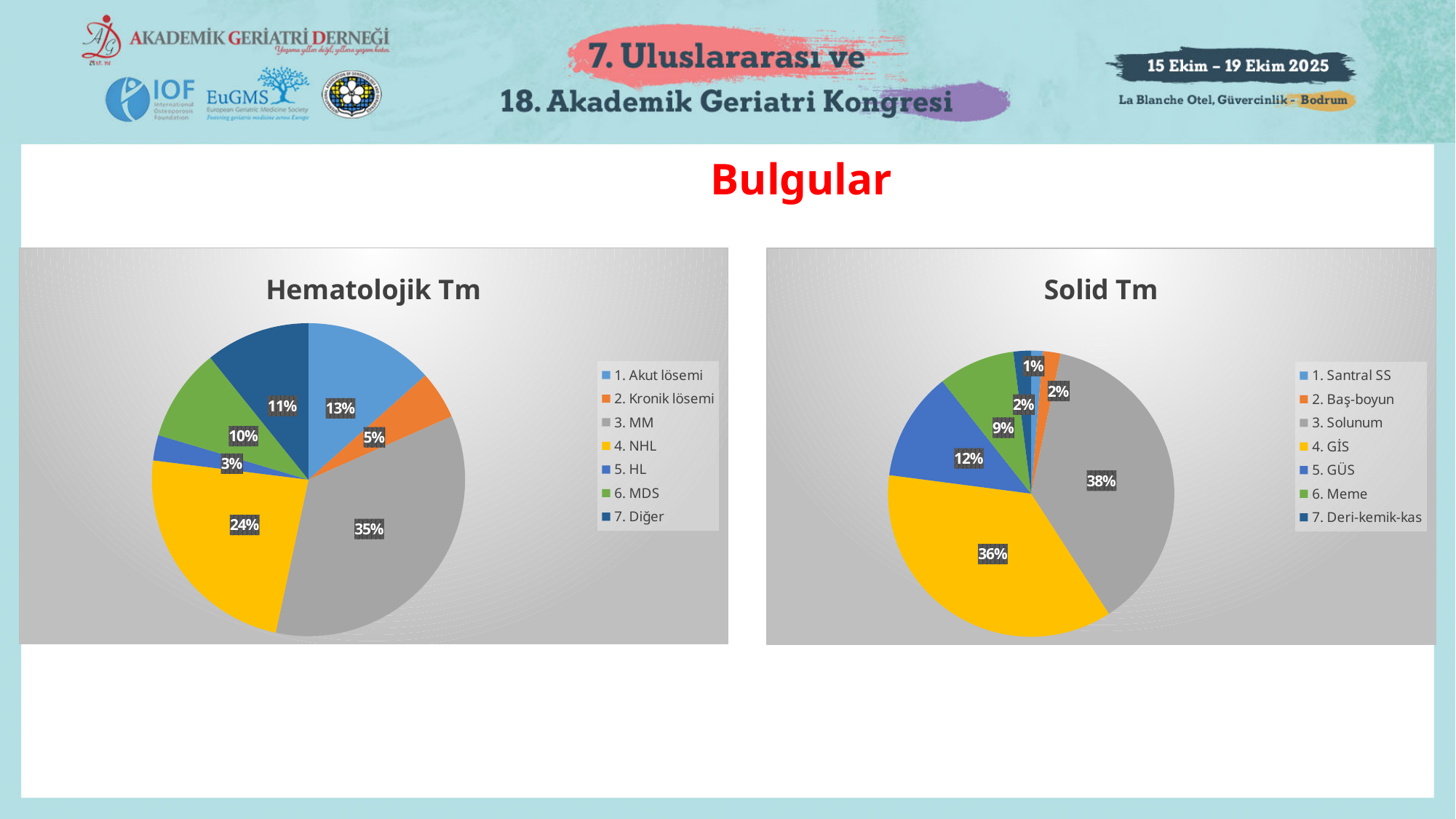
In the Hematolojik Tm chart, which category has the smallest share? 5. HL In the Hematolojik Tm chart, what is the difference between the shares of 1. Akut lösemi and 2. Kronik lösemi? 8% In the Solid Tm chart, what share does 4. GİS have? 36% In the Solid Tm chart, what share does 5. GÜS have? 12% What type of chart is the Solid Tm chart? Pie chart In the Hematolojik Tm chart, how many categories does the legend list? 7 In the Solid Tm chart, which category has the smallest share? 1. Santral SS In the Solid Tm chart, which category has the largest share? 3. Solunum In the Hematolojik Tm chart, what share does 3. MM have? 35% In the Hematolojik Tm chart, what share does 4. NHL have? 24% In the Solid Tm chart, which is larger, the share of 6. Meme or the share of 5. GÜS? 5. GÜS In the Hematolojik Tm chart, which category has the largest share? 3. MM